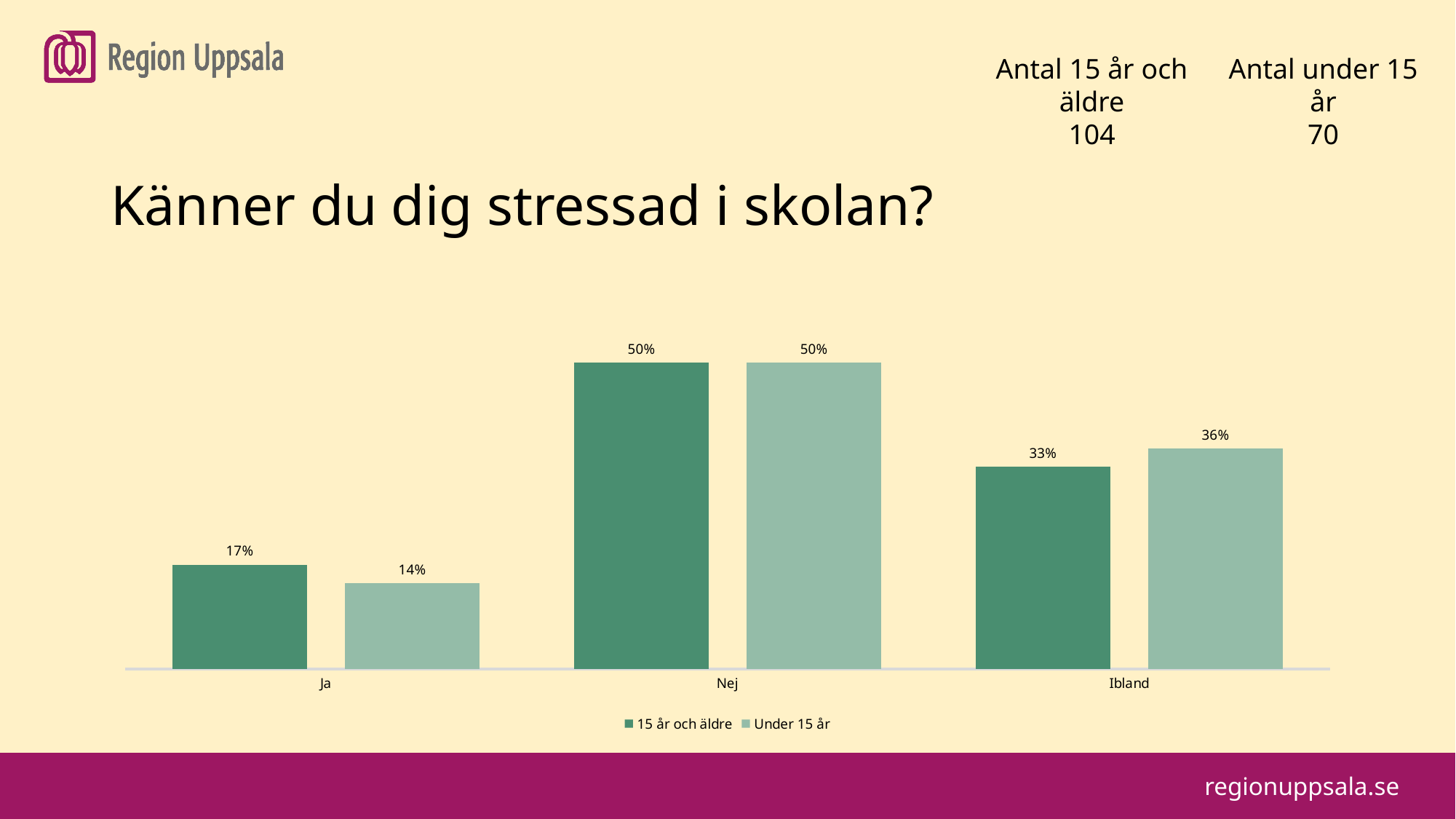
What kind of chart is shown on the slide? Bar chart What is the value for "Nej" in the "15 år och äldre" series? 50% What is the value for "Ja" in the "Under 15 år" series? 14% What is the difference between the "15 år och äldre" and "Under 15 år" values for "Ibland"? 3% For "Ja", which series has the larger value: "15 år och äldre" or "Under 15 år"? 15 år och äldre What is the value for "Ibland" in the "Under 15 år" series? 36% What question is the chart titled with? Känner du dig stressad i skolan? Which category has the lowest value in the "Under 15 år" series? Ja How many series does the legend list? 2 How many categories are shown on the x axis? 3 Which category has the highest value in the "15 år och äldre" series? Nej What is the value for "Ja" in the "15 år och äldre" series? 17%